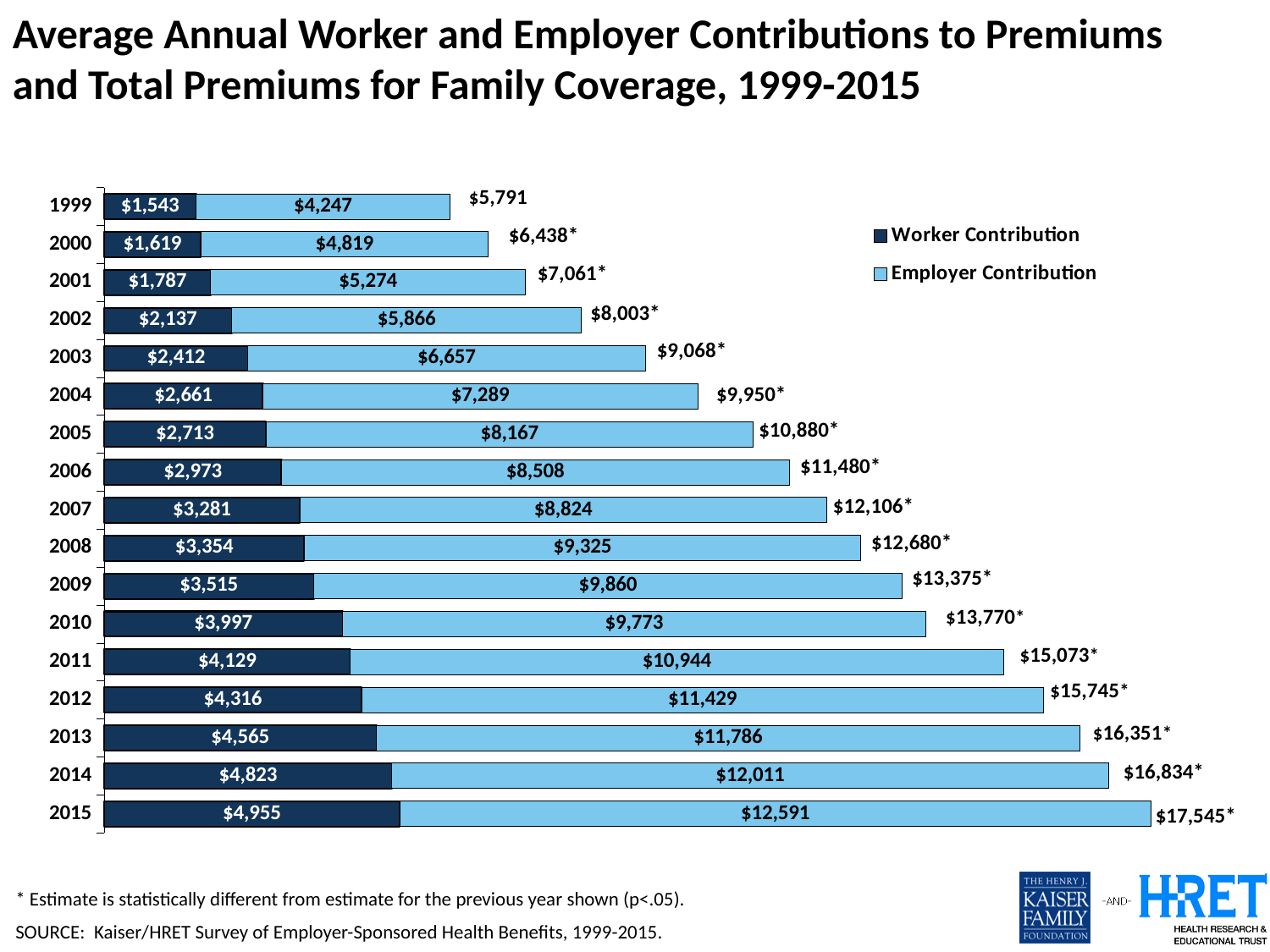
What kind of chart is shown on the slide? Stacked bar chart How many series does the legend list? 2 What is the Worker Contribution for 2005? $2,713 Which year has the lowest Worker Contribution? 1999 Which series is shown in dark blue? Worker Contribution How many years are shown on the chart? 17 Which year has the highest Employer Contribution? 2015 Do the total premiums rise or fall from 1999 to 2015? Rise What is the total premium shown for 2015? $17,545 Which is larger, the Worker Contribution in 2008 or the Worker Contribution in 2012? 2012 What is the Employer Contribution for 2010? $9,773 What is the difference between the Employer Contribution in 2014 and in 2013? $225